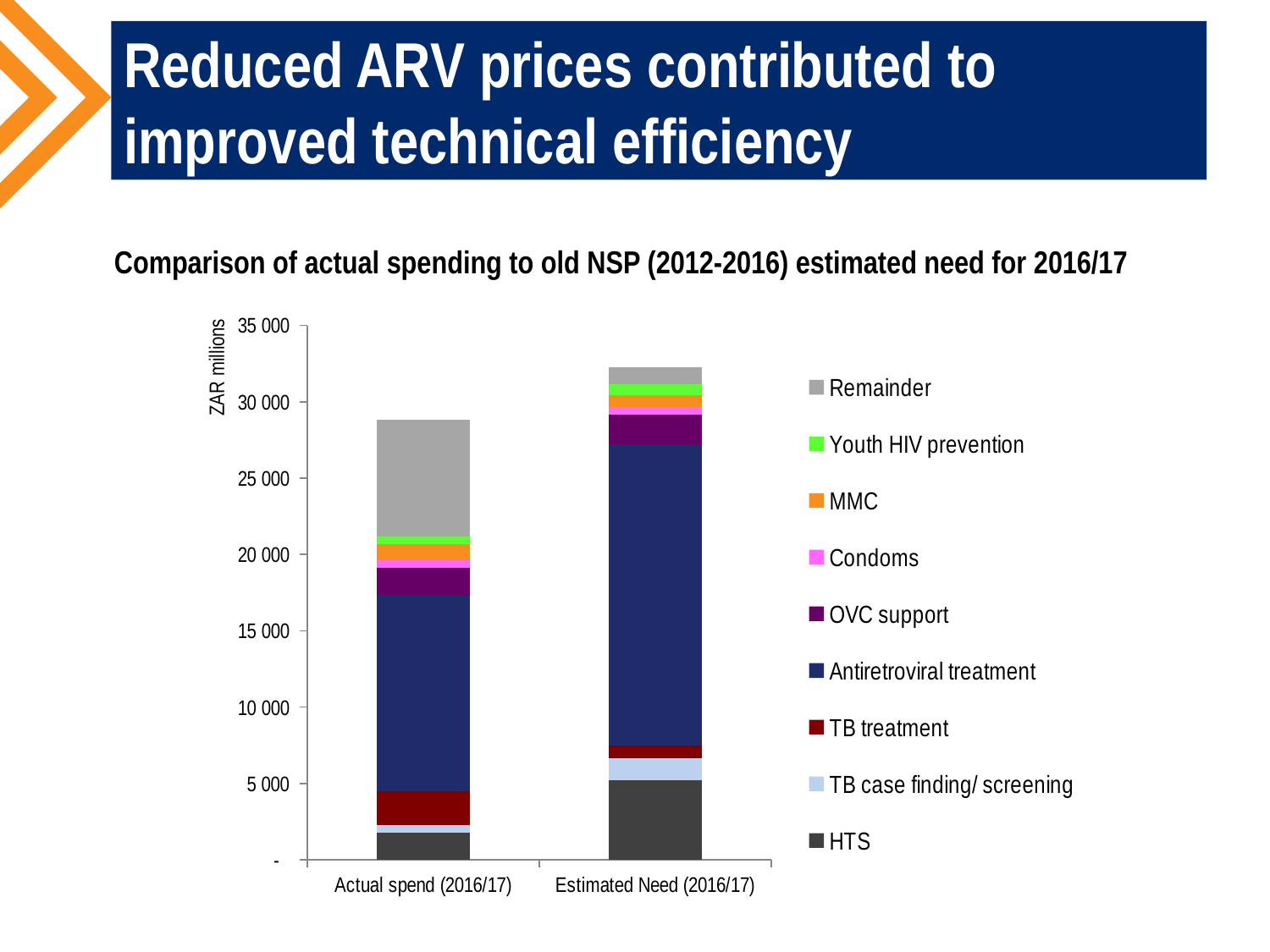
What is the title of the chart? Comparison of actual spending to old NSP (2012-2016) estimated need for 2016/17 What kind of chart is shown on the slide? Stacked bar chart Which series makes up the largest segment of the Estimated Need (2016/17) bar? Antiretroviral treatment Is the total for Estimated Need (2016/17) greater or less than 30 000? greater Is the total for Actual spend (2016/17) greater or less than 25 000? greater What unit is shown on the vertical axis label? ZAR millions Do the bar totals rise or fall from Actual spend (2016/17) to Estimated Need (2016/17)? rise Is the total for Actual spend (2016/17) greater or less than 30 000? less Which bar is taller, Actual spend (2016/17) or Estimated Need (2016/17)? Estimated Need (2016/17) How many bars (categories) are plotted on the x axis? 2 How many series does the legend list? 9